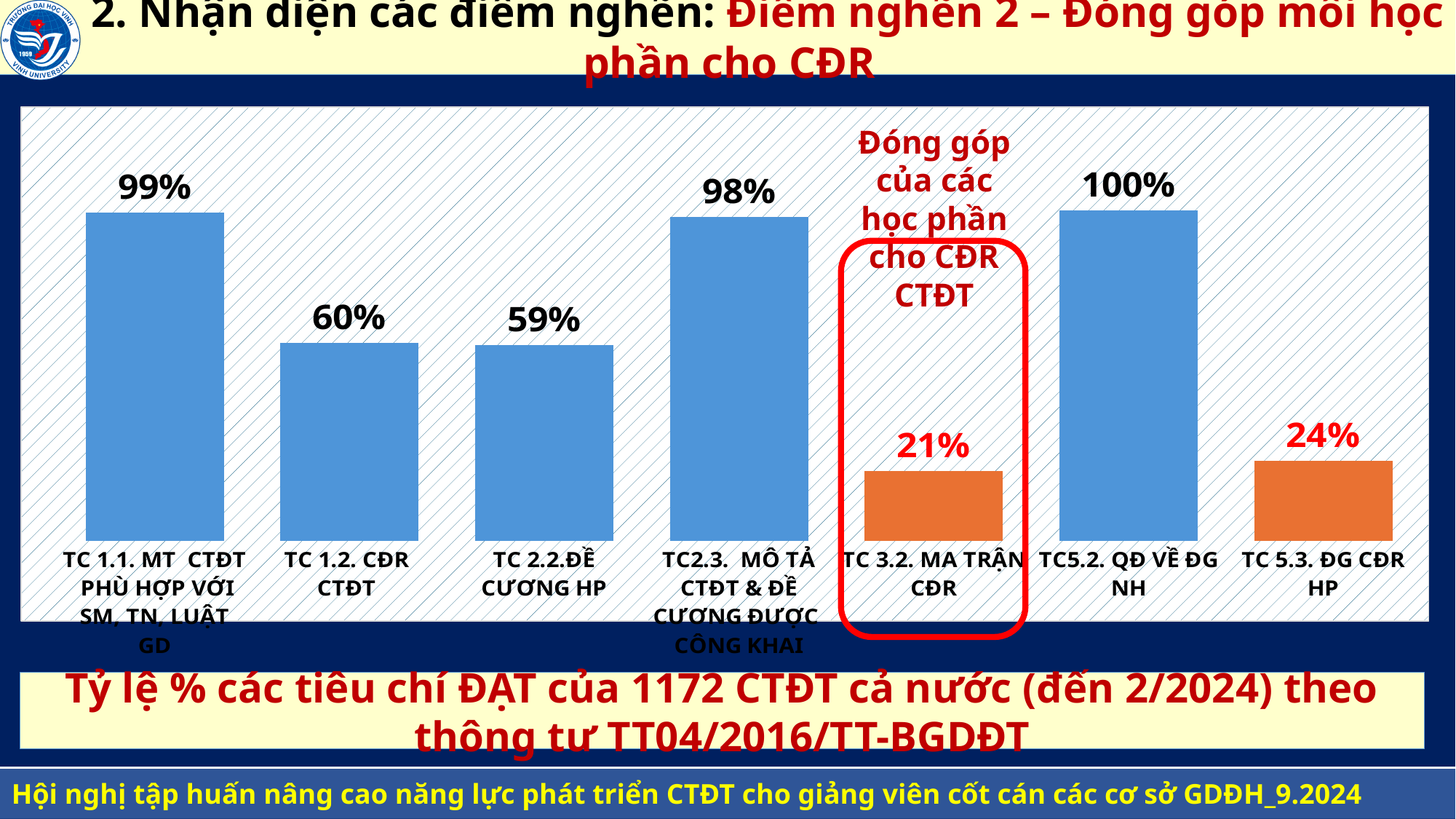
What is the value for TC 1.2. CĐR CTĐT? 60% Which two bars are coloured orange instead of blue? TC 3.2. MA TRẬN CĐR and TC 5.3. ĐG CĐR HP What is the value for TC 3.2. MA TRẬN CĐR? 21% What is the value for TC 5.3. ĐG CĐR HP? 24% What is the value for TC2.3. MÔ TẢ CTĐT & ĐỀ CƯƠNG ĐƯỢC CÔNG KHAI? 98% How many categories (bars) does the chart show? 7 Which category has the lowest value? TC 3.2. MA TRẬN CĐR What is the difference between the values for TC 1.1. MT CTĐT PHÙ HỢP VỚI SM, TN, LUẬT GD and TC 1.2. CĐR CTĐT? 39% What is the difference between the values for TC 5.3. ĐG CĐR HP and TC 3.2. MA TRẬN CĐR? 3% What type of chart is shown on the slide? Bar chart Which category has the highest value? TC5.2. QĐ VỀ ĐG NH Which is larger, the value for TC 2.2. ĐỀ CƯƠNG HP or the value for TC 5.3. ĐG CĐR HP? TC 2.2. ĐỀ CƯƠNG HP